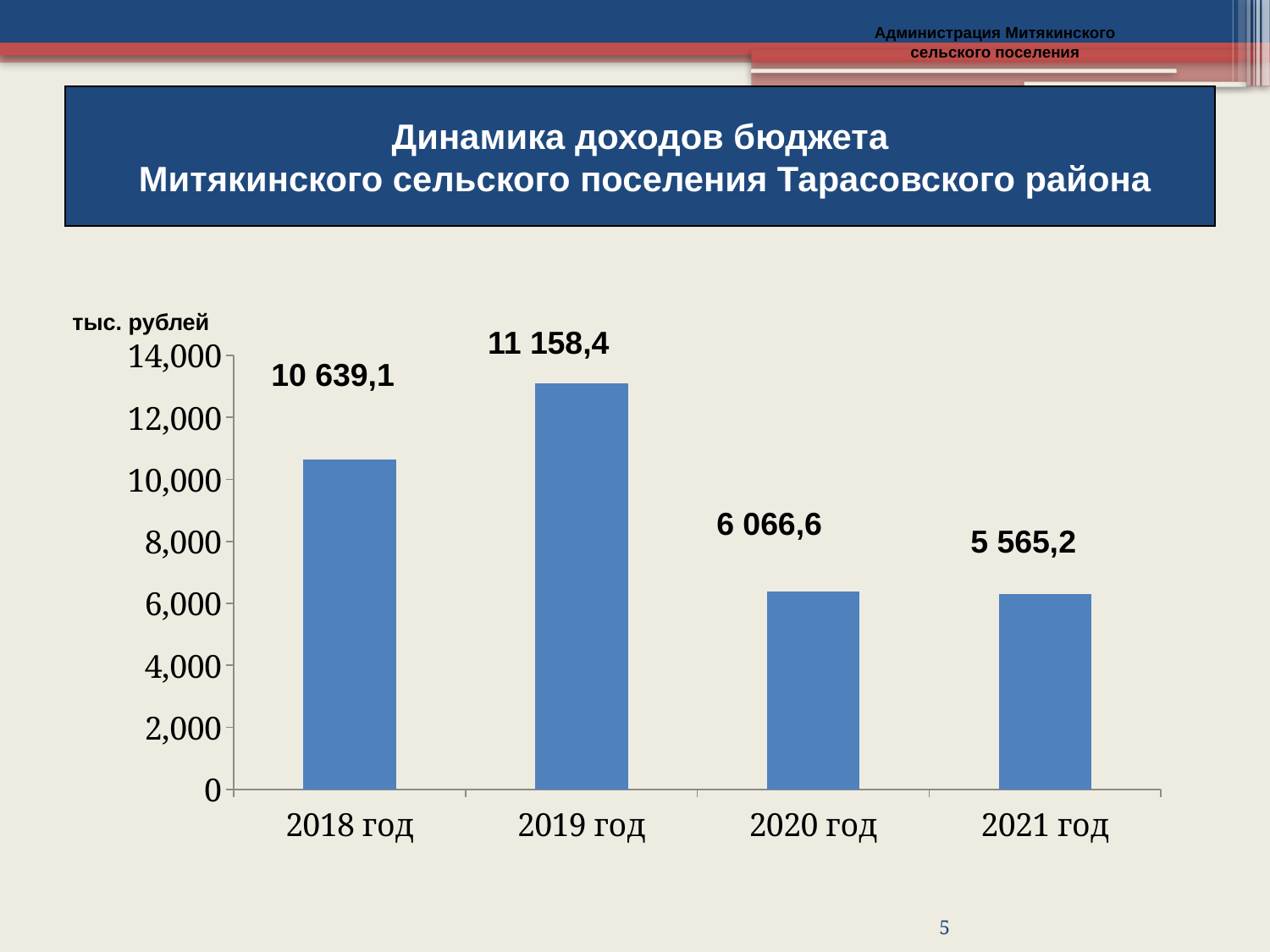
What is the difference between the values for 2019 год and 2018 год? 519,3 Is the value for 2021 год greater or less than 8,000? less Which year has the highest budget revenue? 2019 год What is the budget revenue value shown for 2019 год? 11 158,4 What is the difference between the values for 2018 год and 2020 год? 4 572,5 Which is larger, the value for 2018 год or 2019 год? 2019 год What unit of measurement is indicated above the vertical axis? тыс. рублей What is the value shown for 2018 год? 10 639,1 Which year has the lowest budget revenue? 2021 год What kind of chart is shown on the slide? bar chart How many years are shown on the chart? 4 What is the value shown for 2021 год? 5 565,2